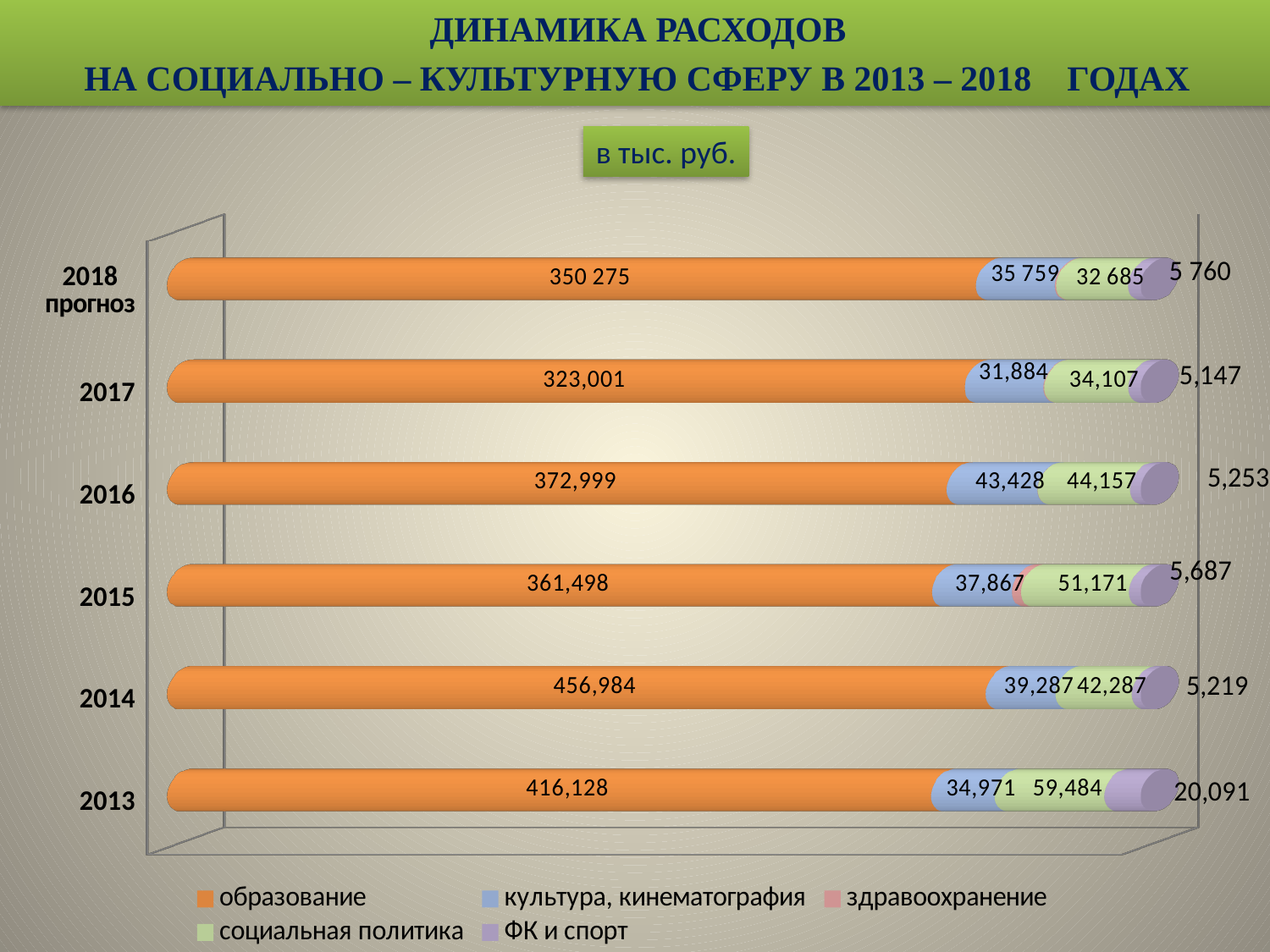
In which year is the value for образование the lowest? 2017 How many years (categories) are shown on the chart? 6 What is the difference between the образование values for 2014 and 2013? 40,856 How many series does the legend list? 5 Which is larger: the культура, кинематография value for 2014 or for 2015? 2014 What is the value for социальная политика in 2013? 59,484 In which year is the value for образование the highest? 2014 What is the value for ФК и спорт in 2018 прогноз? 5 760 What is the value for образование in 2014? 456,984 What kind of chart is shown on the slide? Stacked bar chart In which year is the value for ФК и спорт the highest? 2013 What is the value for культура, кинематография in 2016? 43,428